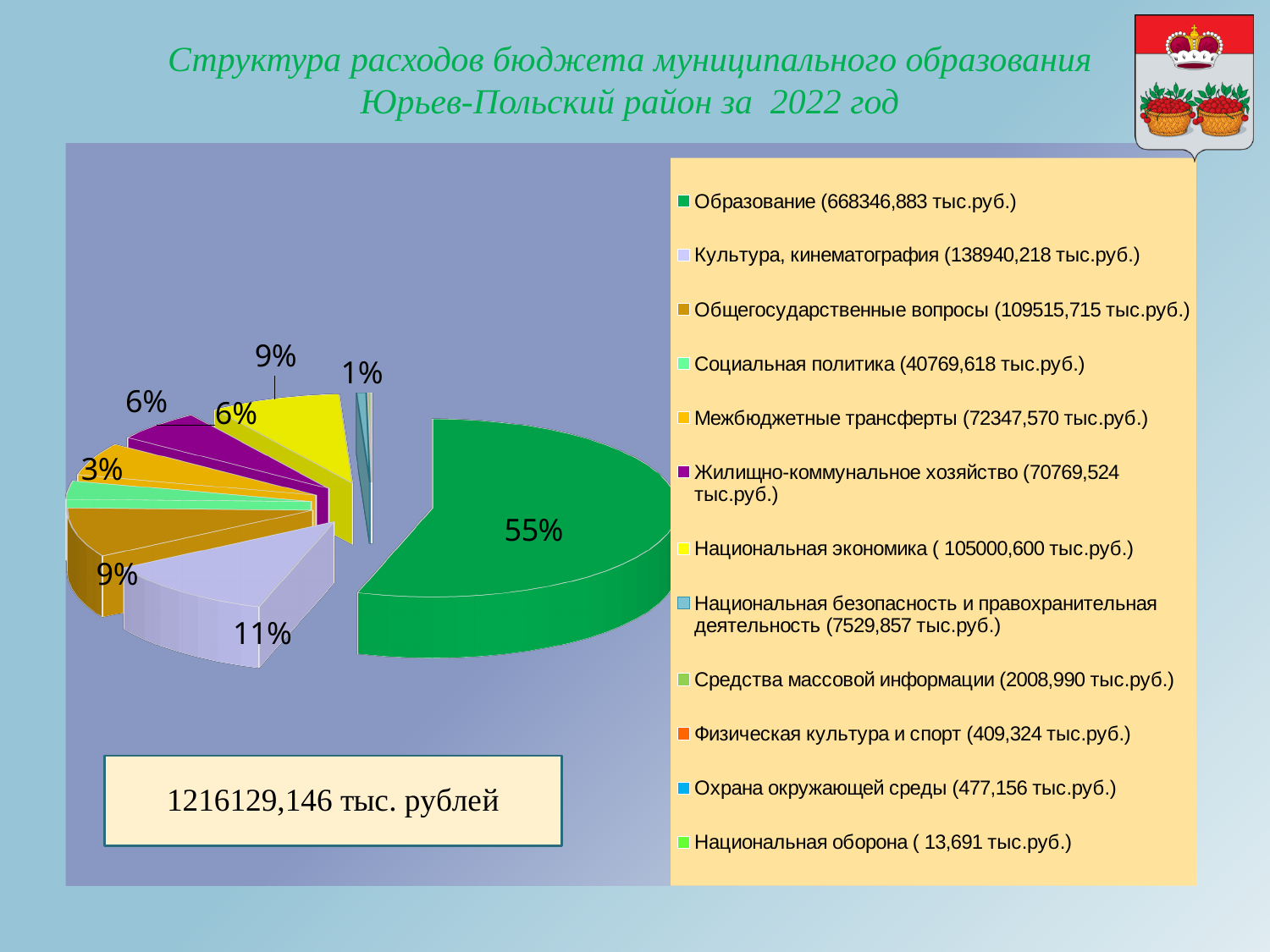
Which has the larger share: Культура, кинематография or Общегосударственные вопросы? Культура, кинематография Which category has the largest share of the pie? Образование What kind of chart is shown on the slide? Pie chart How many percentage points larger is the share of Образование than the share of Культура, кинематография? 44 percentage points What share of the pie does Культура, кинематография take? 11% Which category has the smallest amount listed in the legend? Национальная оборона What share of the pie does Национальная экономика take? 9% What amount is given in the legend for Образование? 668346,883 тыс.руб. How many categories does the legend list? 12 What amount is given in the legend for Межбюджетные трансферты? 72347,570 тыс.руб. What share of the pie does Образование take? 55% What amount is given in the legend for Национальная оборона? 13,691 тыс.руб.